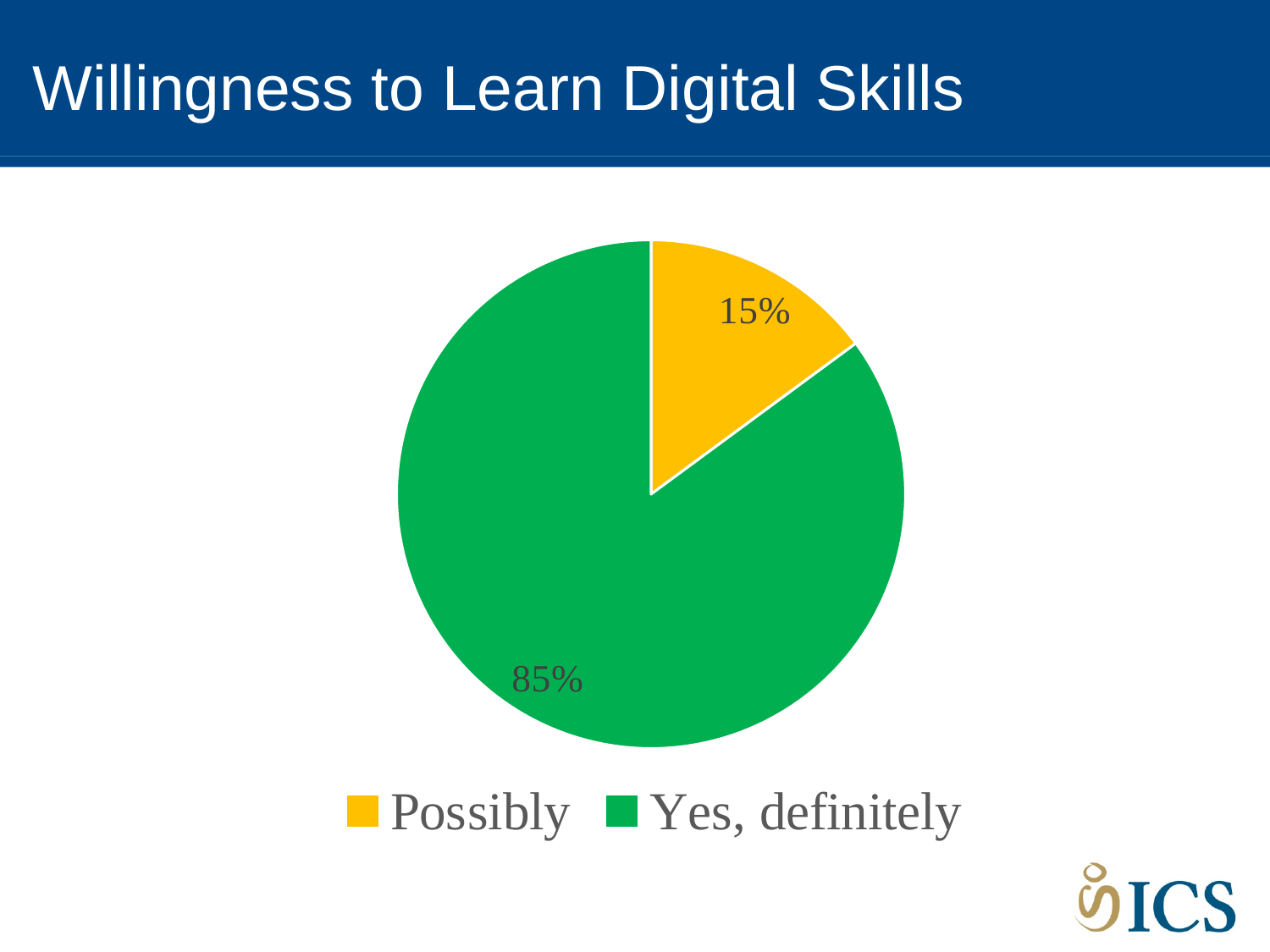
What share of the pie does "Yes, definitely" take? 85% What kind of chart is shown on the slide? pie chart Which category has the smallest slice of the pie? Possibly What is the title of the slide containing the pie chart? Willingness to Learn Digital Skills What share of the pie does "Possibly" take? 15% What is the difference in percentage points between "Yes, definitely" and "Possibly"? 70 Which category has the largest slice of the pie? Yes, definitely How many categories does the pie chart show? 2 How many entries does the legend list? 2 Which is larger, the slice for "Possibly" or the slice for "Yes, definitely"? Yes, definitely What is the total of the two slices shown in the pie chart? 100% What colour is the "Possibly" slice? yellow